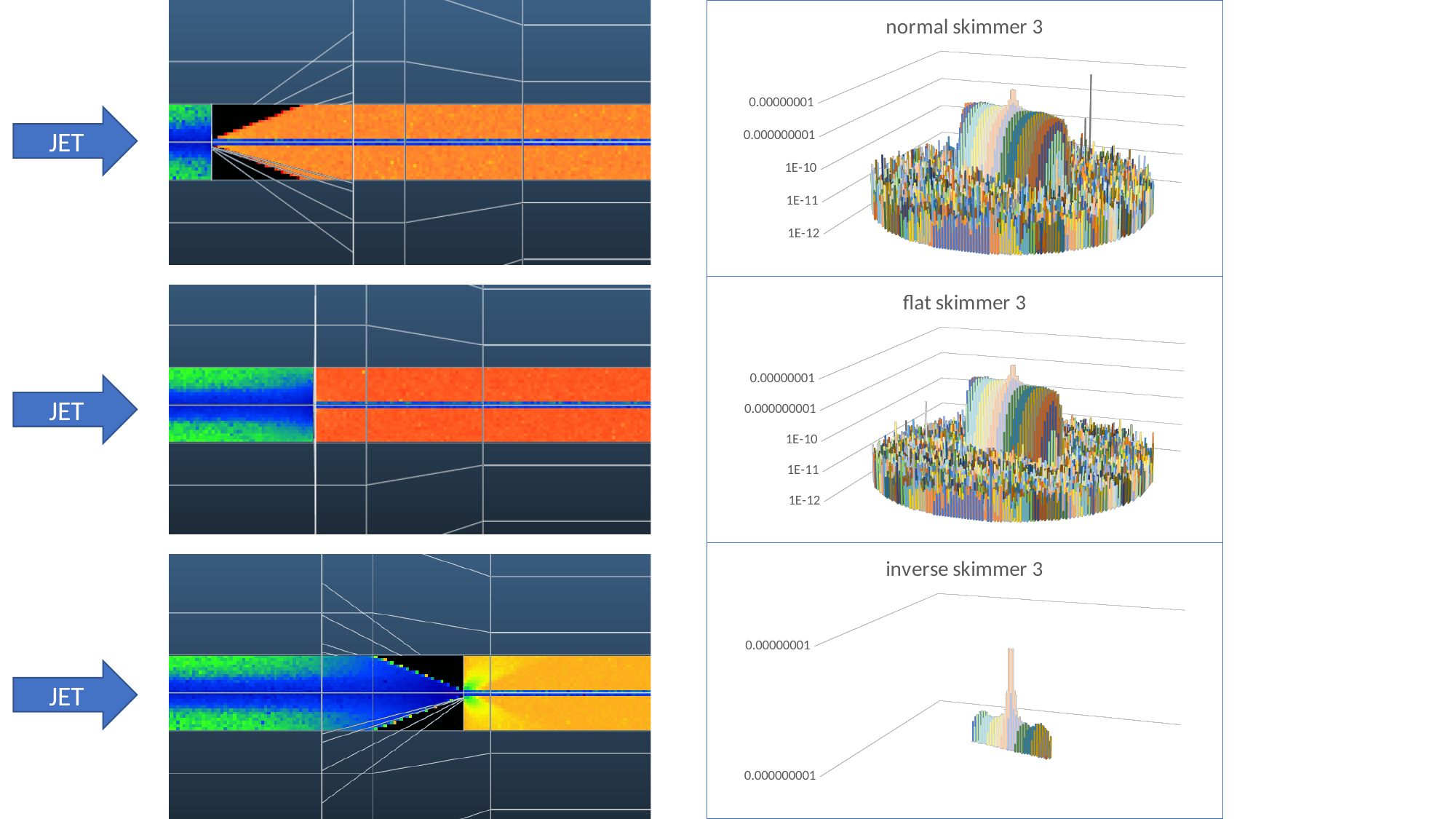
What kind of chart is "inverse skimmer 3"? bar chart Which of the three charts has the fewest bars plotted? inverse skimmer 3 What is the title of the top chart on the right side of the slide? normal skimmer 3 How many charts are shown on the right side of the slide? 3 In the "normal skimmer 3" chart, are the bars in the central plateau higher or lower than the surrounding bars? higher What kind of chart is "normal skimmer 3"? bar chart What is the lowest value labelled on the vertical axis of the "flat skimmer 3" chart? 1E-12